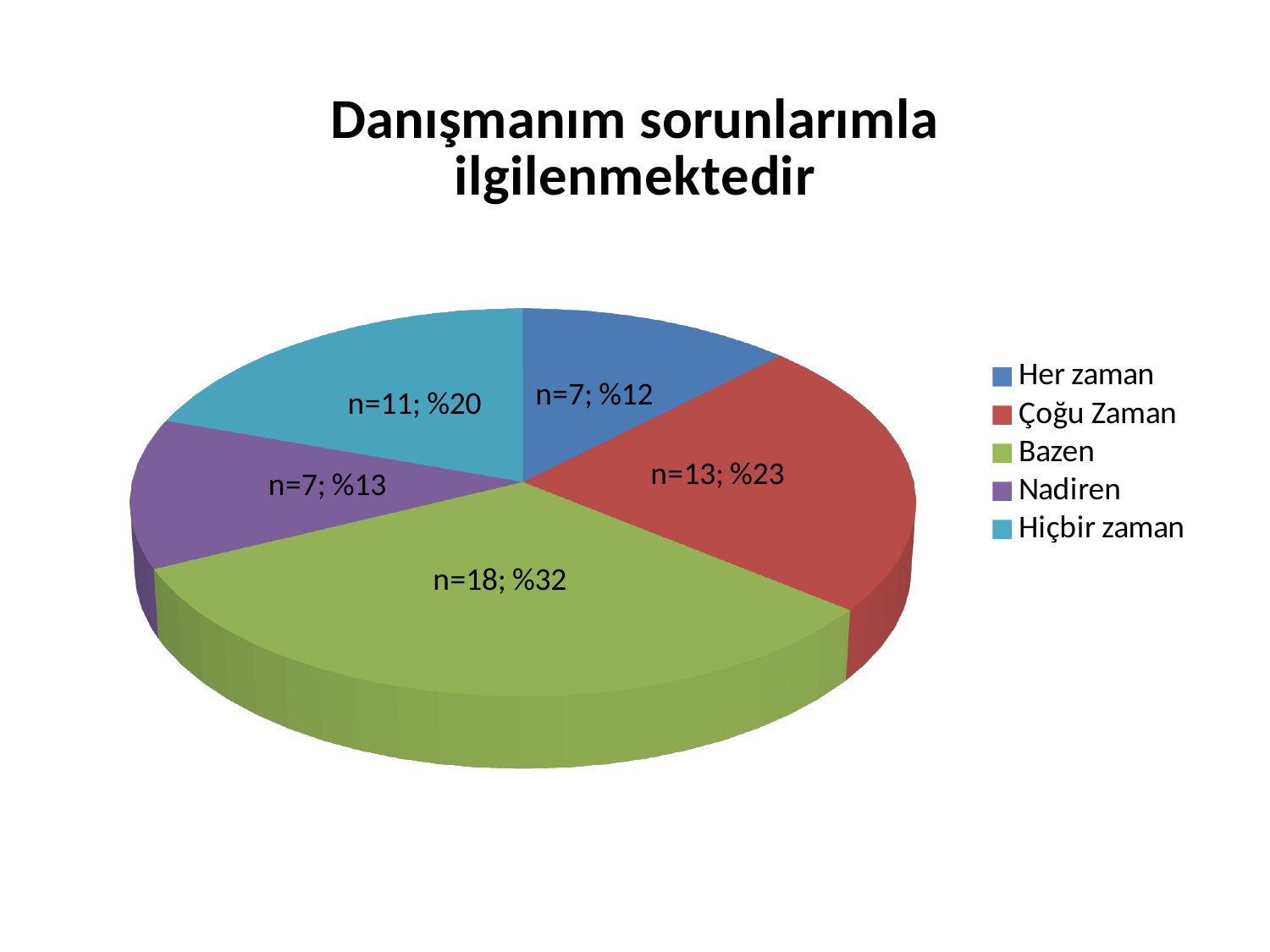
What kind of chart is shown on the slide? pie chart What percentage share does Hiçbir zaman have? %20 How many categories does the legend list? 5 What is the difference in n between Bazen and Çoğu Zaman? 5 What is the n value for Bazen? n=18 What is the title of the chart? Danışmanım sorunlarımla ilgilenmektedir Which category has the smallest percentage share? Her zaman What percentage share does Bazen have? %32 Which category has the largest slice? Bazen What is the n value for Çoğu Zaman? n=13 Which has a larger share, Hiçbir zaman or Nadiren? Hiçbir zaman What percentage share does Her zaman have? %12